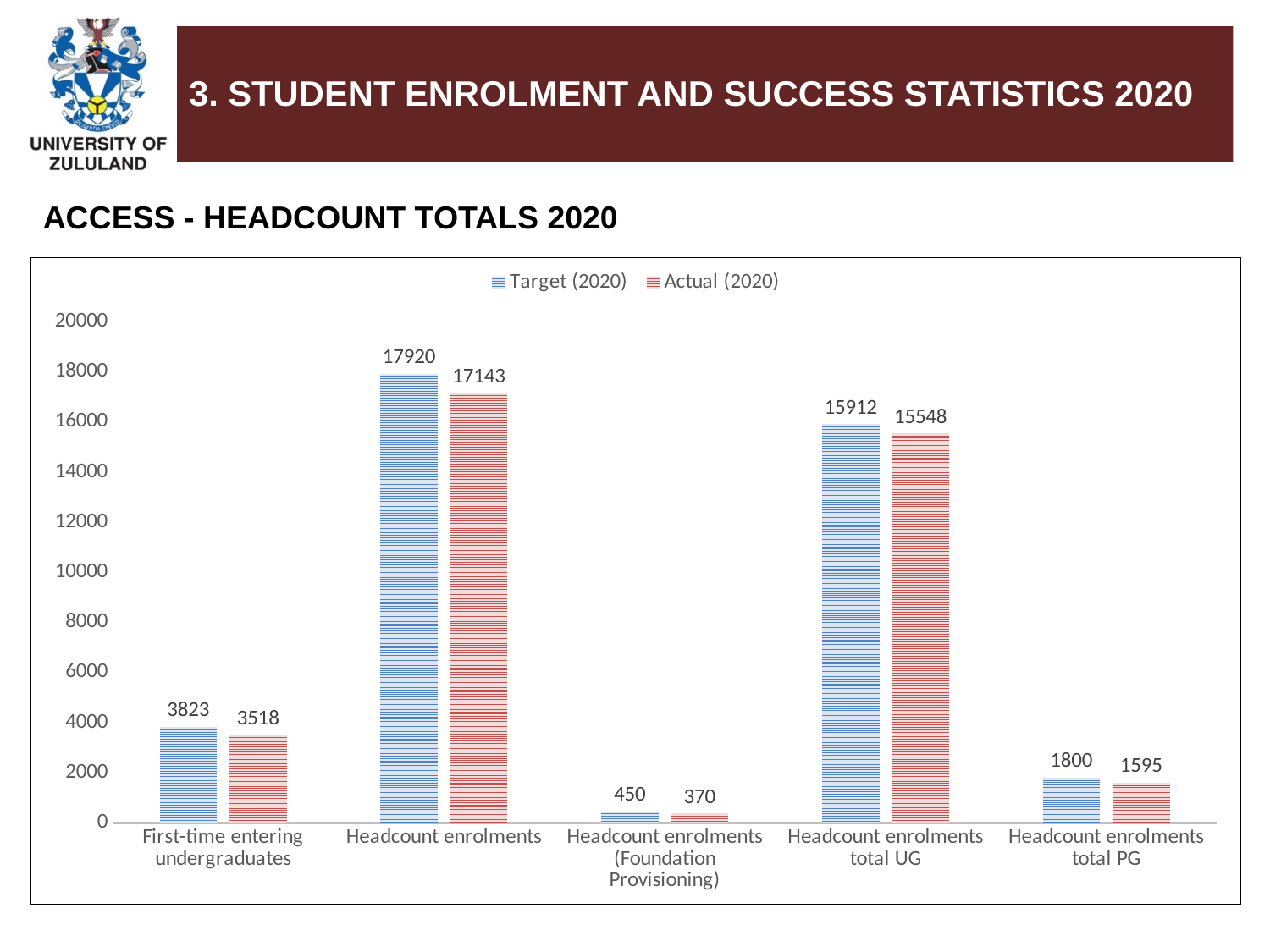
What is the Target (2020) value for Headcount enrolments? 17920 How many series does the legend list? 2 What is the Actual (2020) value for Headcount enrolments total PG? 1595 What is the difference between the Target (2020) and Actual (2020) values for Headcount enrolments total UG? 364 Which is larger for Headcount enrolments total PG: the Target (2020) value or the Actual (2020) value? Target (2020) What is the Actual (2020) value for First-time entering undergraduates? 3518 Is the Actual (2020) value for Headcount enrolments greater or less than 16000? greater What is the difference between the Target (2020) and Actual (2020) values for Headcount enrolments (Foundation Provisioning)? 80 How many categories are shown on the x axis? 5 Which category has the highest Target (2020) value? Headcount enrolments What kind of chart is shown on the slide? bar chart Which category has the lowest Actual (2020) value? Headcount enrolments (Foundation Provisioning)